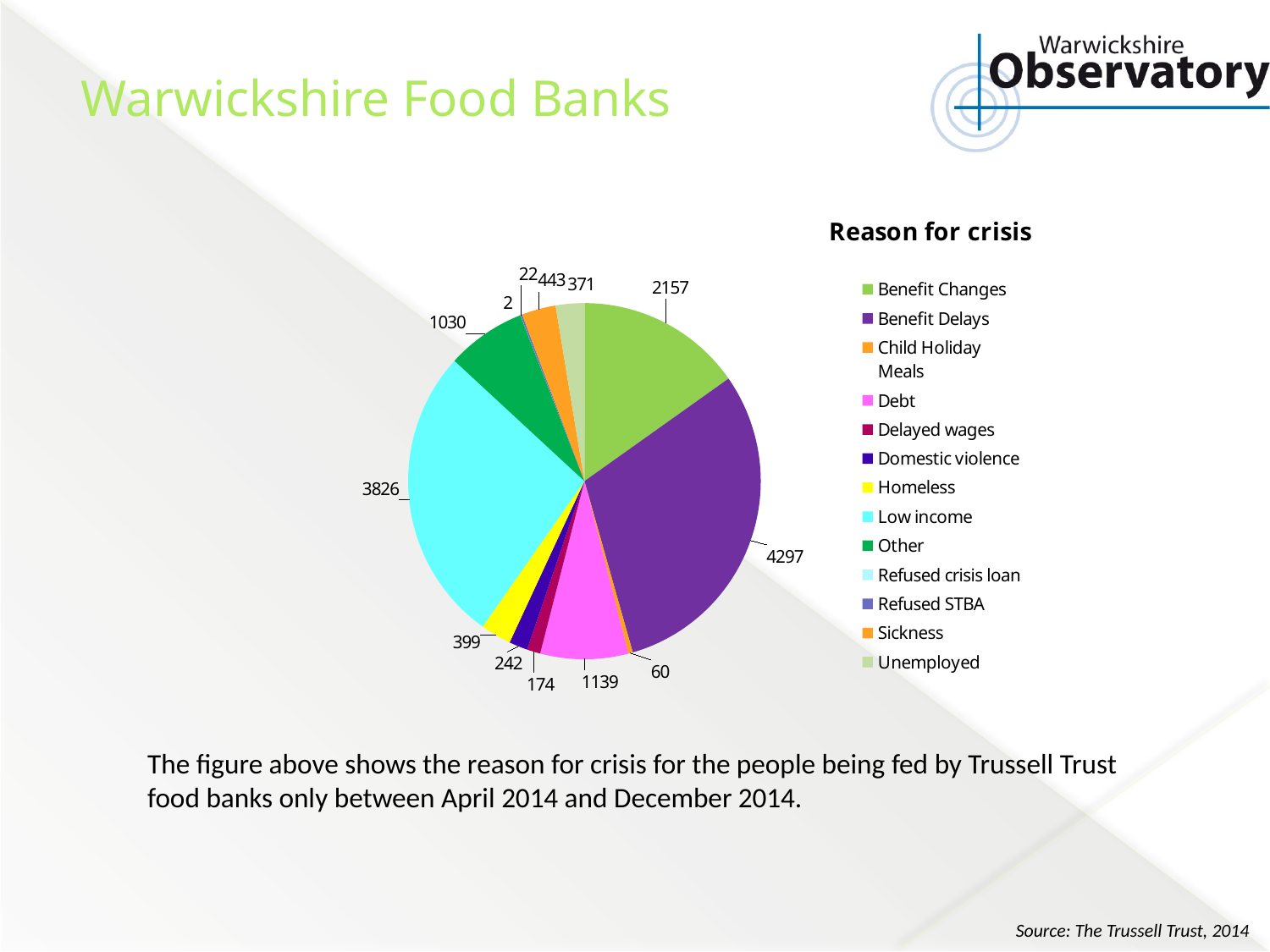
How many categories does the legend of the pie chart list? 13 What is the difference between the values for Benefit Delays and Benefit Changes? 2140 What is the value for Child Holiday Meals? 60 What is the value for Debt? 1139 What is the difference between the values for Homeless and Domestic violence? 157 Which reason for crisis has the smallest value? Refused crisis loan What is the value for Low income? 3826 What kind of chart is shown on the slide? Pie chart What is the title of the chart? Reason for crisis What is the value for Benefit Delays? 4297 Which reason for crisis has the largest slice of the pie? Benefit Delays Which is larger, the value for Other or the value for Sickness? Other